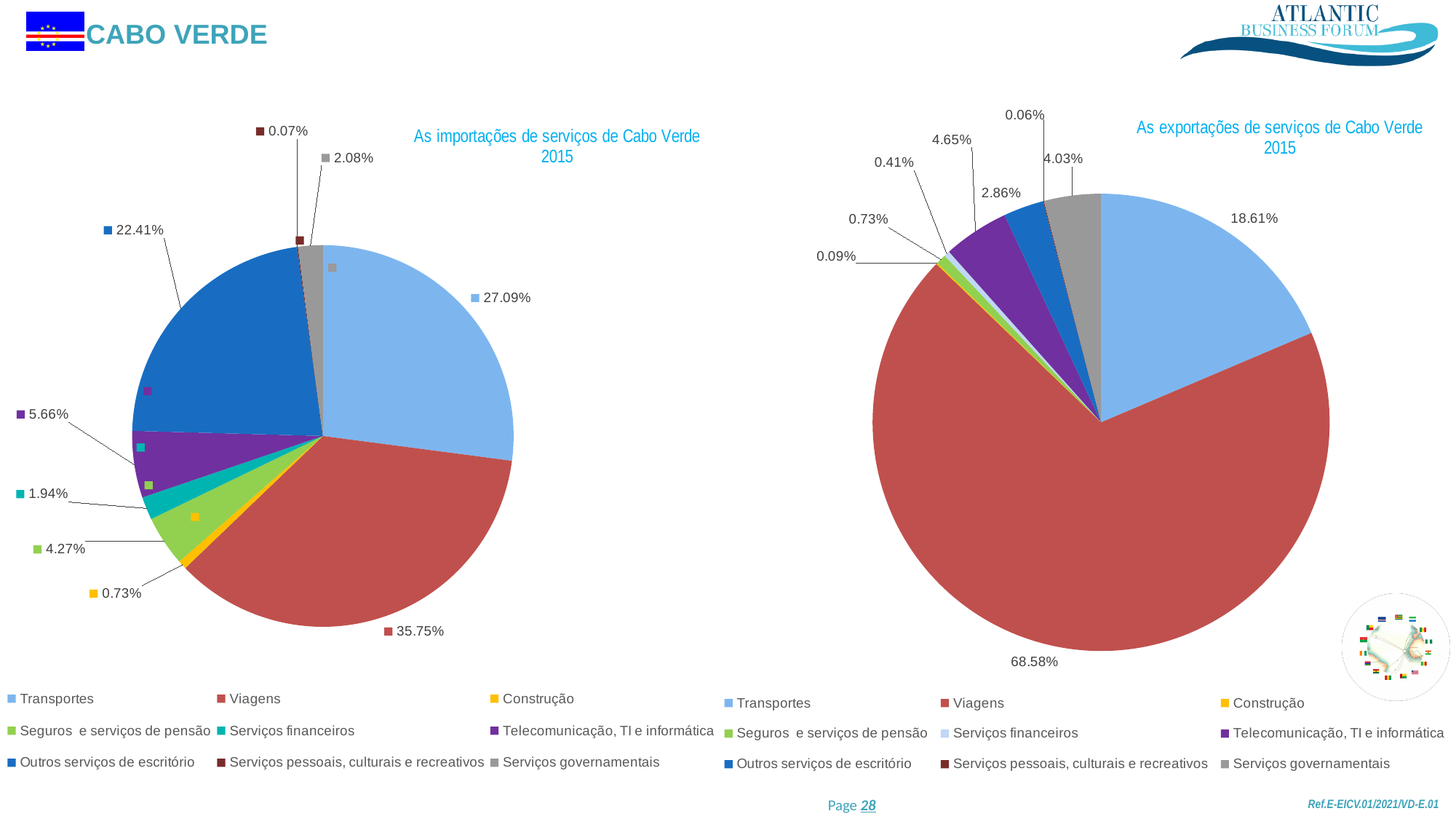
In the chart 'As importações de serviços de Cabo Verde 2015', what share does Transportes have? 27.09% How many categories does the legend of the chart 'As importações de serviços de Cabo Verde 2015' list? 9 What type of chart is 'As exportações de serviços de Cabo Verde 2015'? Pie chart In the chart 'As importações de serviços de Cabo Verde 2015', which category has the smallest share? Serviços pessoais, culturais e recreativos In the chart 'As exportações de serviços de Cabo Verde 2015', what share does Viagens have? 68.58% In the chart 'As exportações de serviços de Cabo Verde 2015', what share does Transportes have? 18.61% In the chart 'As importações de serviços de Cabo Verde 2015', which colour represents Viagens? Red In the chart 'As importações de serviços de Cabo Verde 2015', what is the difference between the shares of Viagens and Transportes? 8.66% In the chart 'As importações de serviços de Cabo Verde 2015', what share does Viagens have? 35.75% In the chart 'As exportações de serviços de Cabo Verde 2015', which is larger: Telecomunicação, TI e informática or Serviços governamentais? Telecomunicação, TI e informática In the chart 'As exportações de serviços de Cabo Verde 2015', which category has the largest share? Viagens In the chart 'As importações de serviços de Cabo Verde 2015', what share does Outros serviços de escritório have? 22.41%